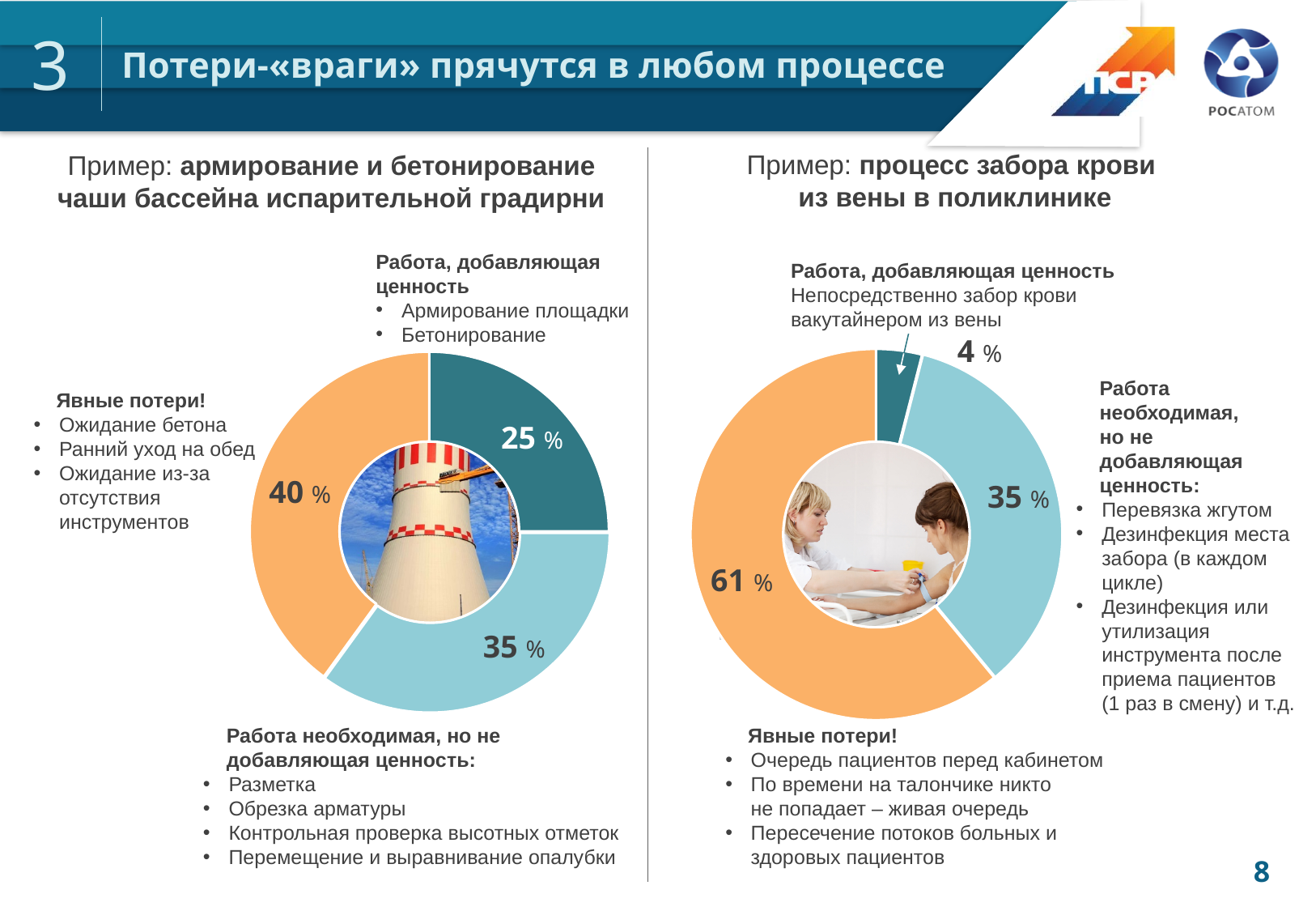
On the right chart, which category has the largest share? Явные потери On the left chart (reinforcement and concreting of the cooling tower basin), what share is labelled as value-adding work (Работа, добавляющая ценность)? 25 % Which chart shows a larger share of value-adding work, the left one or the right one? The left one On the left chart, which category has the largest share? Явные потери On the right chart, what share is labelled as obvious losses (Явные потери)? 61 % On the right chart (blood draw process in a clinic), what share is labelled as value-adding work? 4 % On the left chart, what is the difference between the obvious losses share and the value-adding share? 15 % On the left chart, what share is labelled as obvious losses (Явные потери)? 40 % On the left chart, what share is labelled as necessary but non-value-adding work? 35 % On the right chart, which category has the smallest share? Работа, добавляющая ценность On the right chart, what is the difference between the obvious losses share and the necessary non-value-adding share? 26 % What type of chart is used on both sides of the slide? Pie (donut) chart